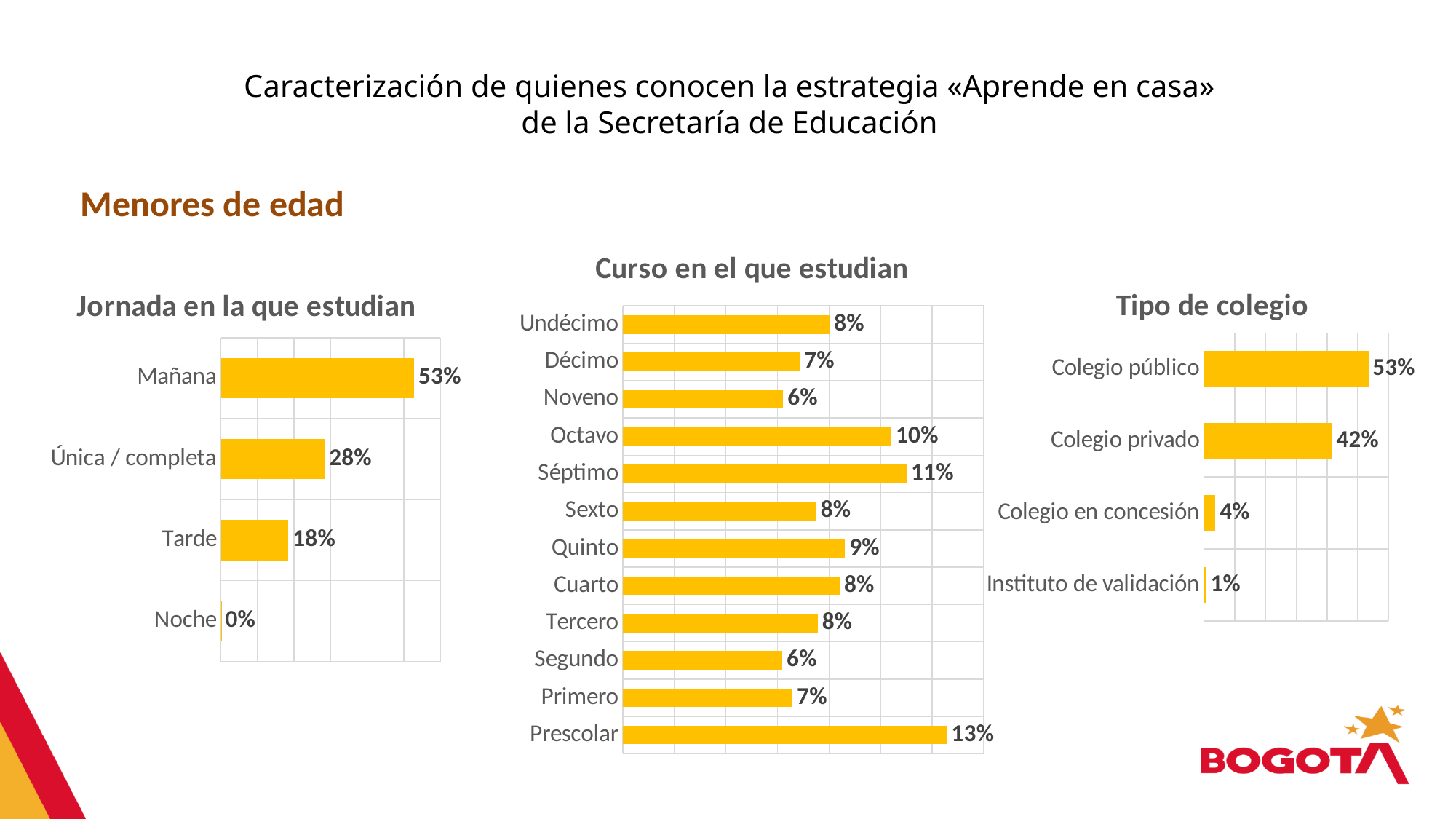
In the 'Jornada en la que estudian' chart, how many categories are shown? 4 In the 'Curso en el que estudian' chart, which is larger, Octavo or Décimo? Octavo In the 'Curso en el que estudian' chart, what is the value for Séptimo? 11% In the 'Curso en el que estudian' chart, which category has the highest value? Prescolar In the 'Tipo de colegio' chart, which category has the lowest value? Instituto de validación In the 'Curso en el que estudian' chart, how many categories are shown? 12 In the 'Tipo de colegio' chart, what is the difference between Colegio público and Colegio privado? 11% In the 'Jornada en la que estudian' chart, what is the difference between Única / completa and Tarde? 10% In the 'Jornada en la que estudian' chart, which category has the lowest value? Noche What kind of chart is the 'Tipo de colegio' chart? Bar chart In the 'Tipo de colegio' chart, what is the value for Colegio privado? 42% In the 'Jornada en la que estudian' chart, what is the value for Mañana? 53%